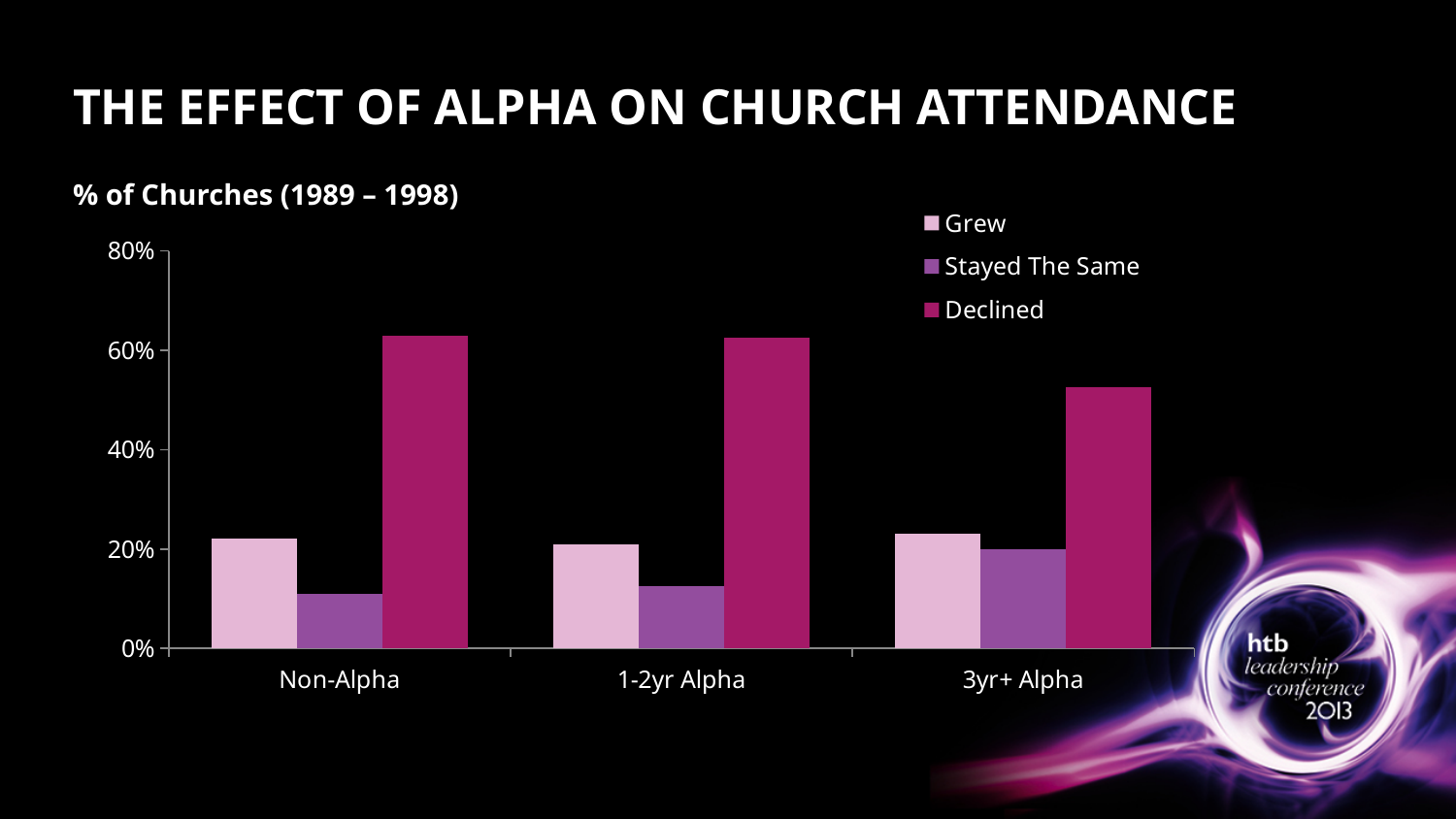
Which is larger for 3yr+ Alpha: Declined or Grew? Declined Does the Stayed The Same series rise or fall from Non-Alpha to 3yr+ Alpha? rise Which category has the highest value for Stayed The Same? 3yr+ Alpha How many series does the legend list? 3 How many categories are shown on the x axis? 3 Is the Declined value for 3yr+ Alpha greater or less than 60%? less Is the Declined value for Non-Alpha greater or less than 60%? greater What kind of chart is shown on the slide? bar chart Which series has the highest value for Non-Alpha churches? Declined Which category has the lowest value for Declined? 3yr+ Alpha Which series has the lowest value for Non-Alpha churches? Stayed The Same Is the Stayed The Same value for Non-Alpha greater or less than 20%? less